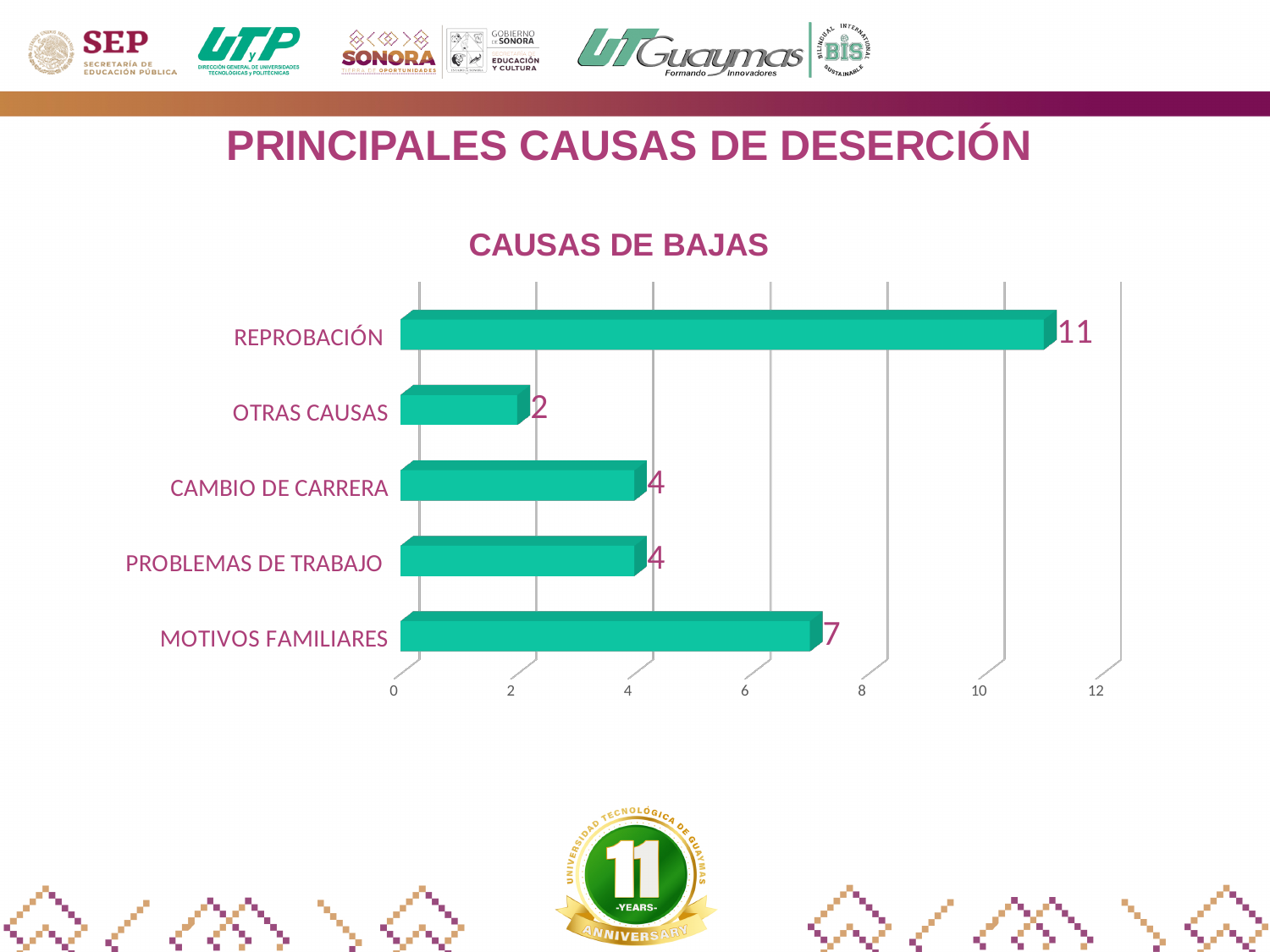
What kind of chart is shown? Bar chart Which category has the highest value? REPROBACIÓN Which is larger, the value for MOTIVOS FAMILIARES or the value for CAMBIO DE CARRERA? MOTIVOS FAMILIARES What is the value for REPROBACIÓN? 11 Which category has the lowest value? OTRAS CAUSAS Is the value for REPROBACIÓN greater or less than 10? greater What is the value for OTRAS CAUSAS? 2 What is the value for MOTIVOS FAMILIARES? 7 What is the title of the chart? CAUSAS DE BAJAS What is the difference between the values for REPROBACIÓN and MOTIVOS FAMILIARES? 4 How many categories are shown in the chart? 5 What is the total of the values for CAMBIO DE CARRERA and PROBLEMAS DE TRABAJO? 8